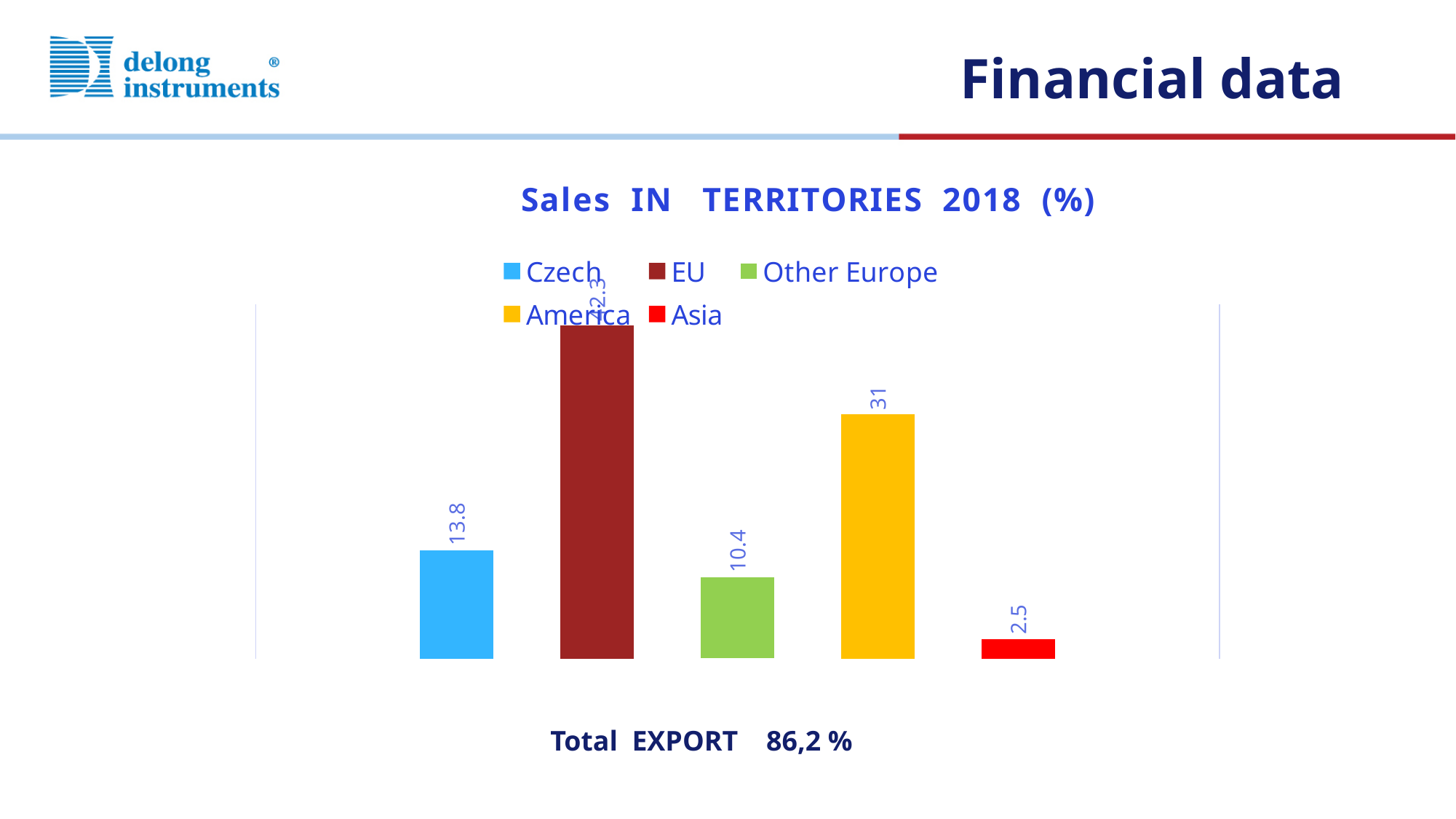
What is the value for Asia? 2.5 What is the value for Other Europe? 10.4 Which is larger, the value for Czech or the value for Other Europe? Czech How many series does the chart legend list? 5 What is the difference between the values for America and Czech? 17.2 What is the value for Czech? 13.8 What kind of chart is shown on the slide? bar chart How many bars are plotted in the chart? 5 Which territory has the highest value? EU Which territory has the lowest value? Asia What is the value for America? 31 What is the title of the chart? Sales IN TERRITORIES 2018 (%)